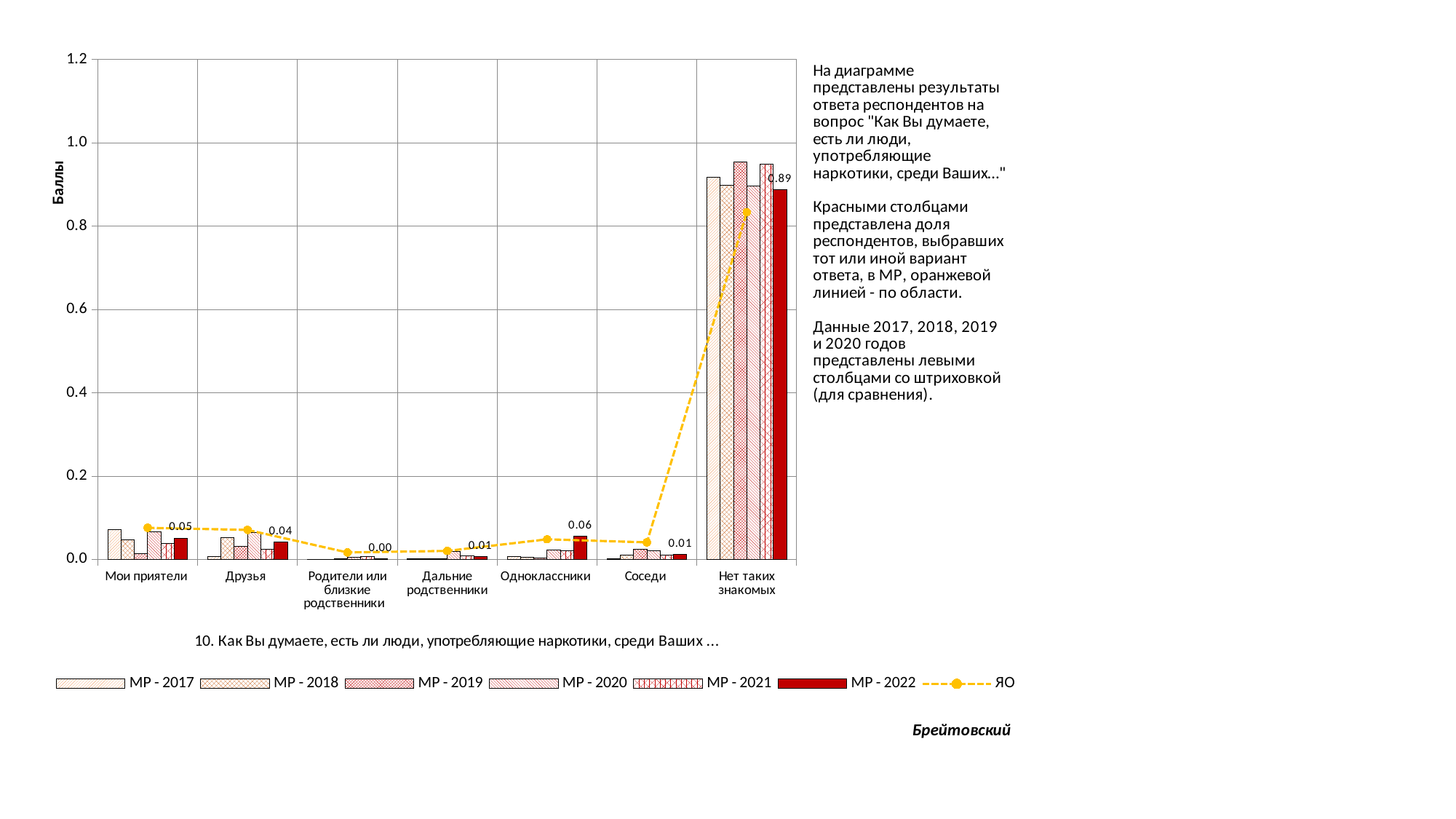
How many series does the legend list? 7 Is the ЯО line value for "Нет таких знакомых" greater or less than 0.8? greater What is the MP - 2022 value for "Родители или близкие родственники"? 0.00 Which category has the highest MP - 2022 value? Нет таких знакомых Which category has the lowest MP - 2022 value? Родители или близкие родственники What is the difference between the MP - 2022 values for "Нет таких знакомых" and "Одноклассники"? 0.83 What is the MP - 2022 value for "Мои приятели"? 0.05 What is the MP - 2022 value for "Нет таких знакомых"? 0.89 Which is larger for MP - 2022: "Мои приятели" or "Друзья"? Мои приятели What is the MP - 2022 value for "Одноклассники"? 0.06 What is the label of the y axis? Баллы How many categories are shown on the x axis? 7